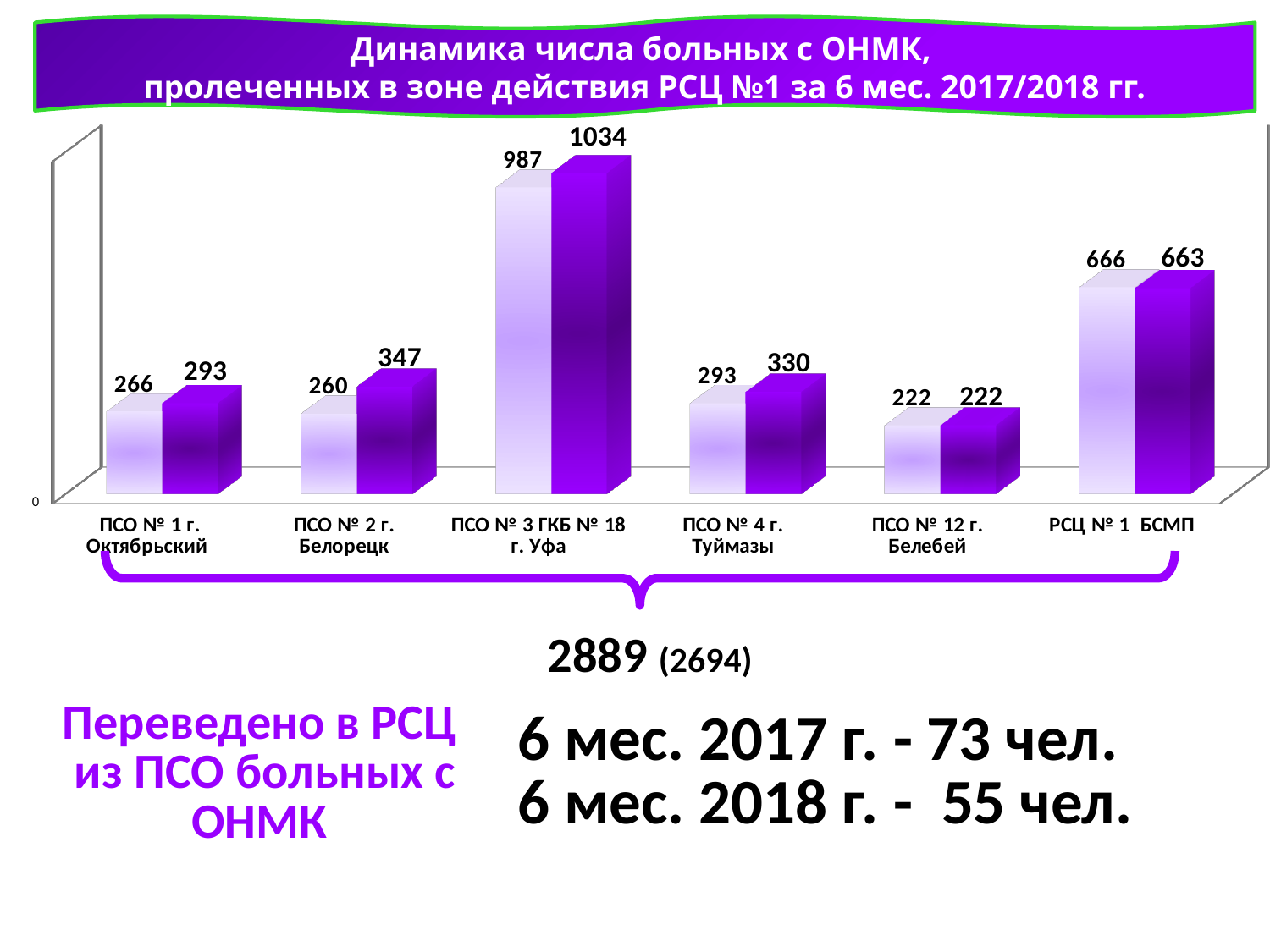
Which category has the highest values in the chart? ПСО № 3 ГКБ № 18 г. Уфа Which is larger for ПСО № 4 г. Туймазы: the light bar or the dark purple bar? the dark purple bar Are the two bars for ПСО № 12 г. Белебей equal, and what is their value? Yes, 222 How many categories are shown on the x axis of the chart? 6 What is the value of the light-coloured bar for ПСО № 3 ГКБ № 18 г. Уфа? 987 Which category has the lowest values in the chart? ПСО № 12 г. Белебей What is the difference between the dark purple bar and the light bar for ПСО № 2 г. Белорецк? 87 What is the difference between the dark purple bar and the light bar for ПСО № 3 ГКБ № 18 г. Уфа? 47 What total is shown below the bracket under the chart? 2889 (2694) What is the value of the dark purple bar for РСЦ № 1 БСМП? 663 What type of chart is shown on the slide? bar chart What is the value of the dark purple bar for ПСО № 2 г. Белорецк? 347